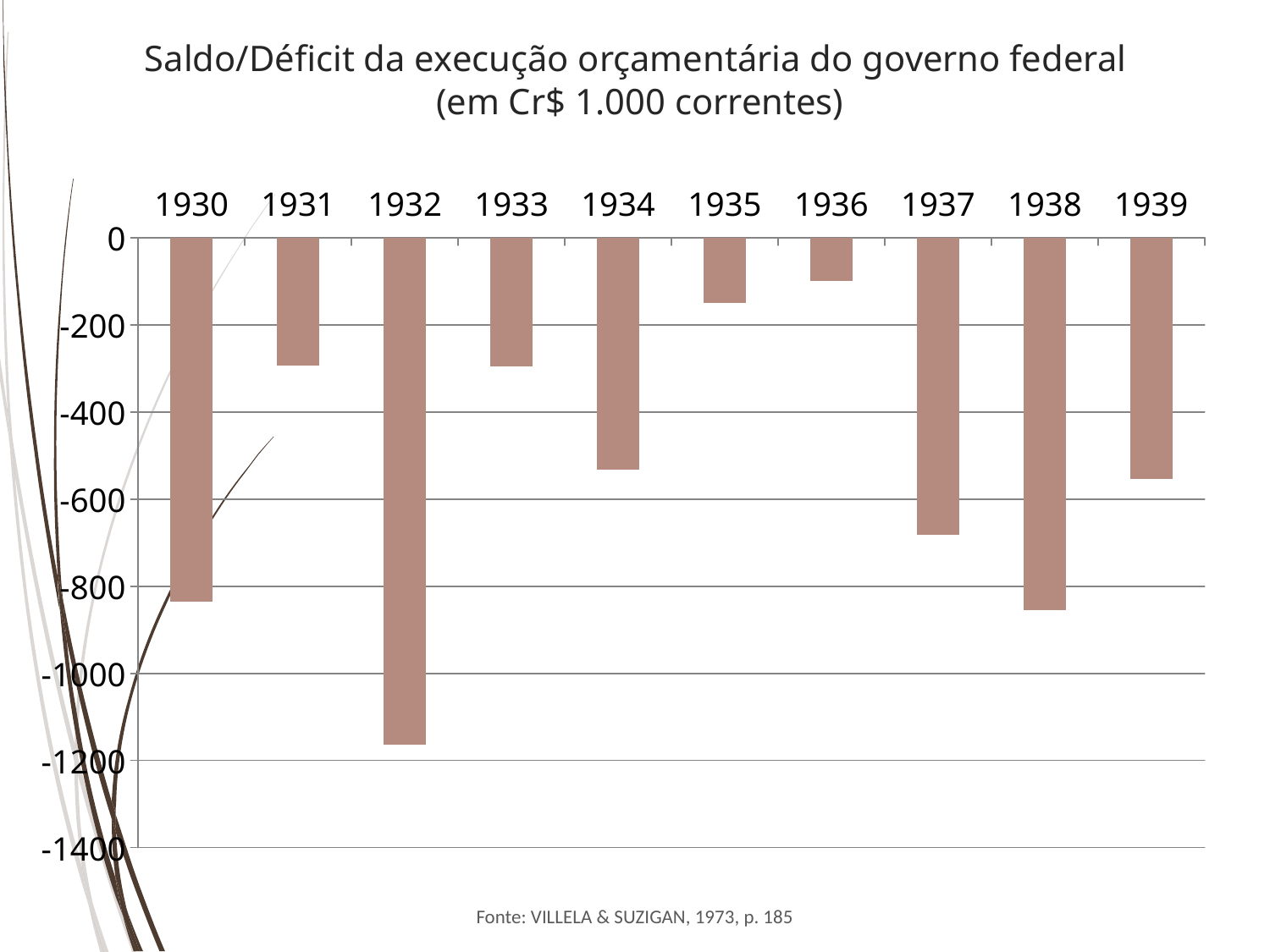
Is the value for 1937 greater or less than -600? less Is the value for 1932 greater or less than -1000? less Is the value for 1939 greater or less than -400? less How many years are plotted on the chart? 10 What kind of chart is shown on the slide? bar chart What is the title of the chart? Saldo/Déficit da execução orçamentária do governo federal (em Cr$ 1.000 correntes) Which year has the largest deficit (the most negative bar)? 1932 Which year has the larger deficit, 1934 or 1937? 1937 Which year has the smallest deficit (the bar closest to 0)? 1936 What source is cited below the chart? VILLELA & SUZIGAN, 1973, p. 185